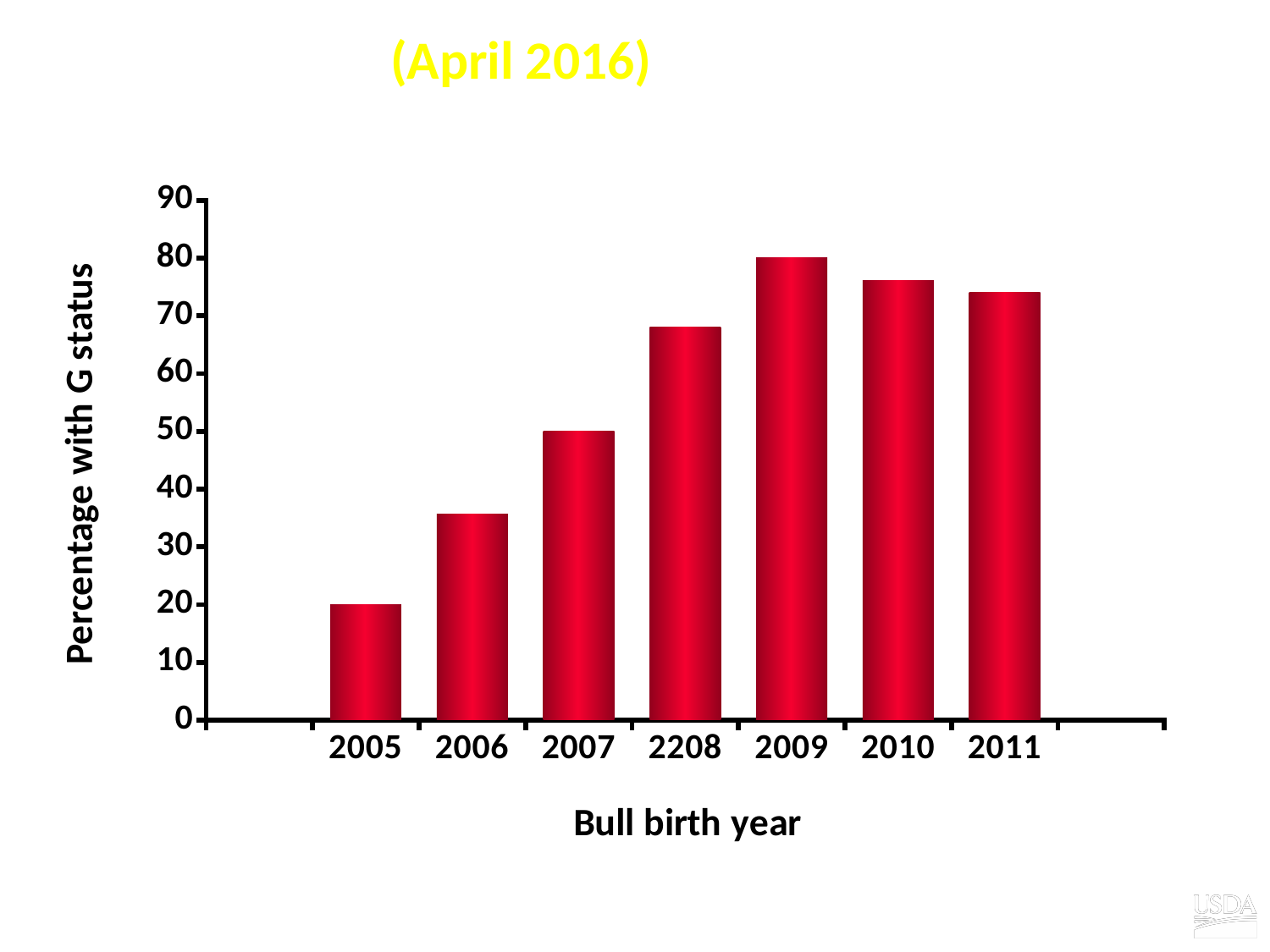
What is the percentage with G status for bulls born in 2007? 50 Is the percentage with G status for the category labelled 2208 greater or less than 60? greater What kind of chart is shown on the slide? bar chart Which bull birth year has the lowest percentage with G status? 2005 Which bull birth year has the highest percentage with G status? 2009 How many bull birth year categories are plotted on the chart? 7 Is the percentage with G status for bulls born in 2006 greater or less than 40? less What is the percentage with G status for bulls born in 2009? 80 Which has a higher percentage with G status: bulls born in 2006 or bulls born in 2007? 2007 What is the percentage with G status for bulls born in 2005? 20 What is the difference in percentage with G status between bulls born in 2009 and bulls born in 2005? 60 What is the title of the x axis of the chart? Bull birth year